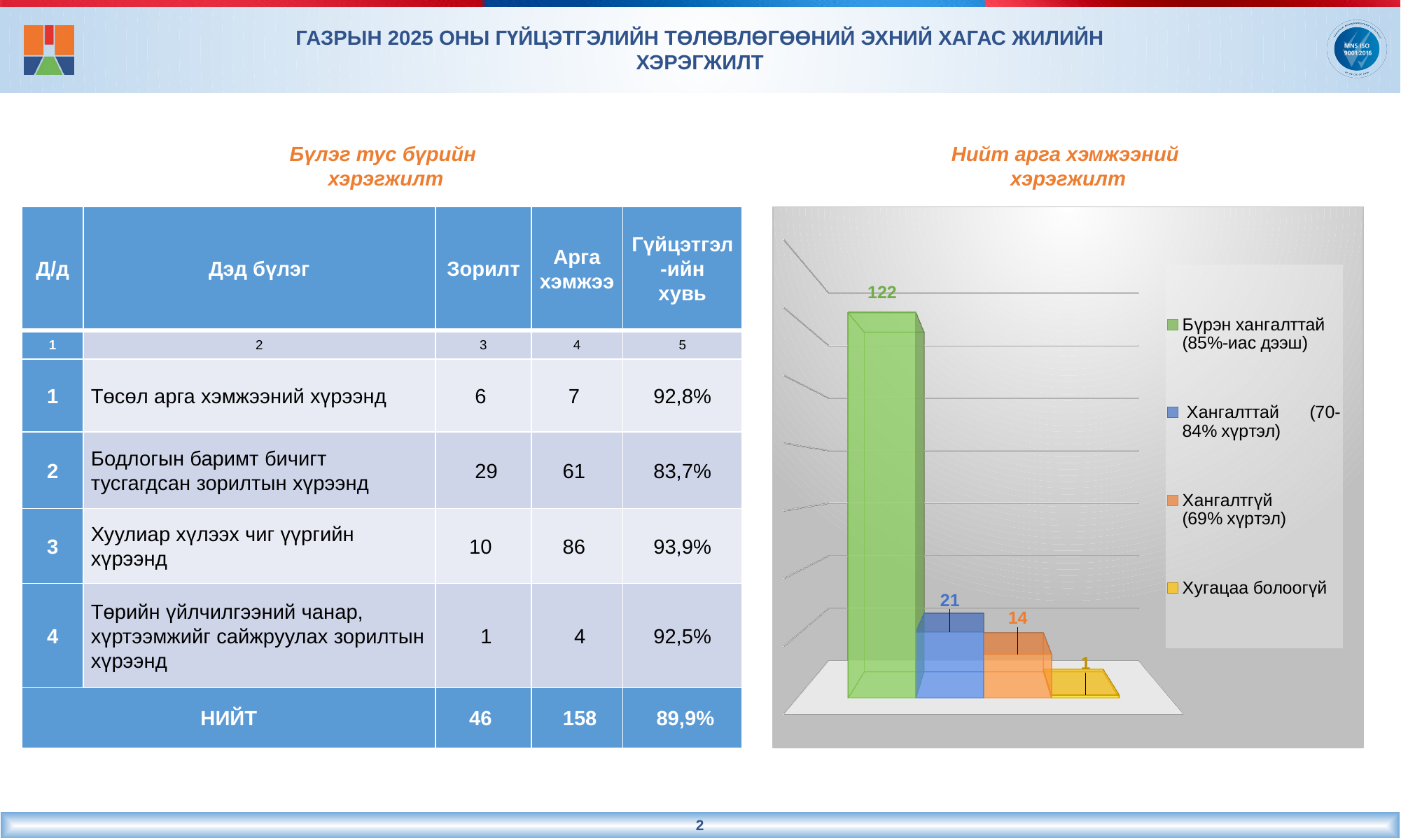
What is the value for "Хангалттай (70-84% хүртэл)" in the chart? 21 Which category has the lowest value in the chart? Хугацаа болоогүй What is the title of the chart on the right of the slide? Нийт арга хэмжээний хэрэгжилт What kind of chart is shown on the right of the slide? Bar chart What is the value for "Хугацаа болоогүй" in the chart? 1 Which is larger in the chart: the value for "Хангалтгүй (69% хүртэл)" or the value for "Хугацаа болоогүй"? Хангалтгүй (69% хүртэл) What is the value for "Бүрэн хангалттай (85%-иас дээш)" in the chart? 122 How many entries does the chart legend list? 4 Which category has the highest value in the chart? Бүрэн хангалттай (85%-иас дээш) What is the value for "Хангалтгүй (69% хүртэл)" in the chart? 14 What is the difference between the values for "Хангалттай (70-84% хүртэл)" and "Хангалтгүй (69% хүртэл)"? 7 What is the difference between the values for "Бүрэн хангалттай (85%-иас дээш)" and "Хангалттай (70-84% хүртэл)"? 101